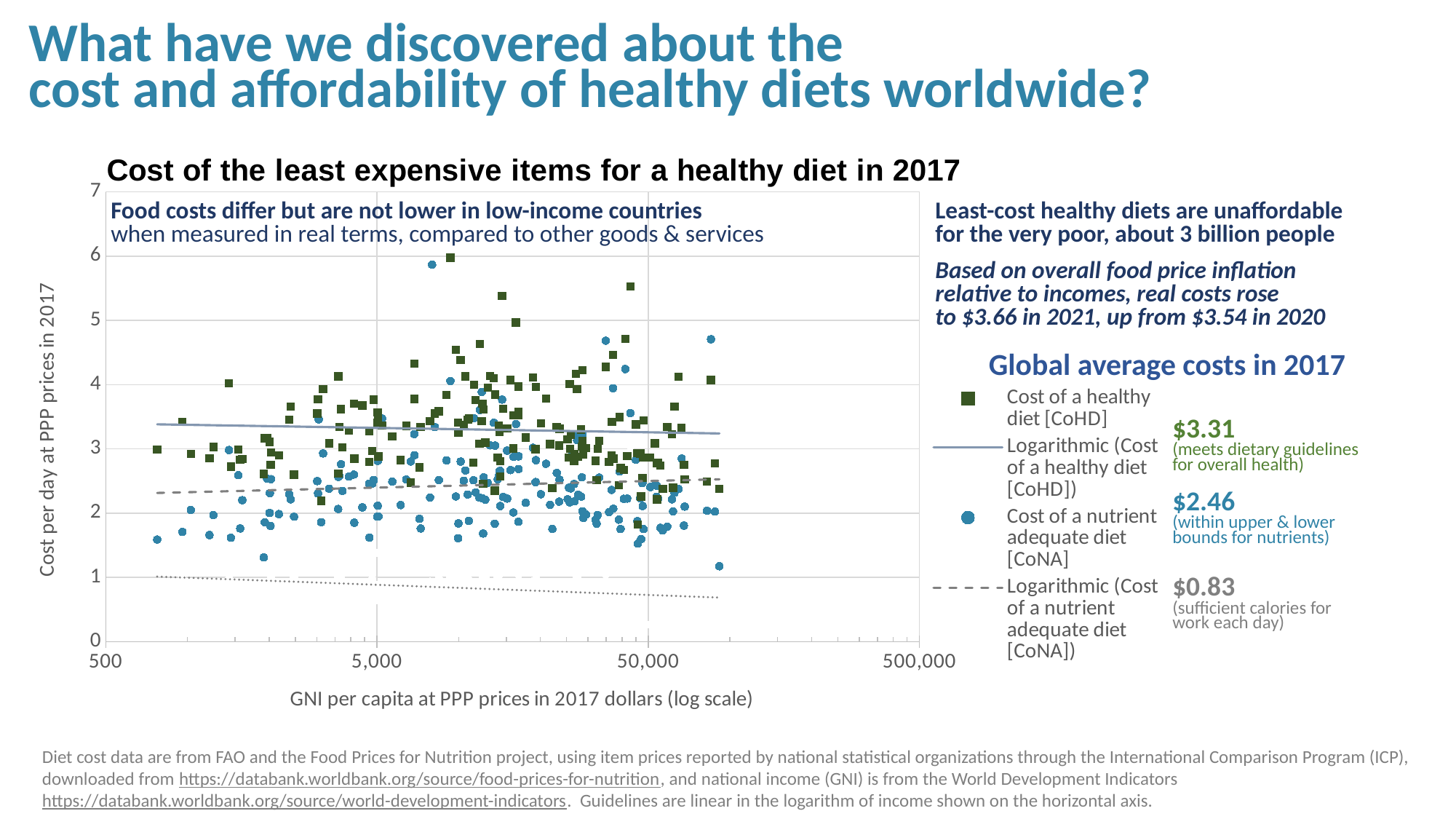
What is the global average cost in 2017 for sufficient calories for work each day? $0.83 Which series contains the lowest plotted point on the chart? Cost of a nutrient adequate diet [CoNA] What is the global average cost of a nutrient adequate diet [CoNA] in 2017 shown on the slide? $2.46 What kind of chart is shown on the slide? Scatter chart How many tick labels are shown on the horizontal (GNI per capita) axis? 4 What is the global average cost of a healthy diet [CoHD] in 2017 shown on the slide? $3.31 What marker shape and colour represent the cost of a healthy diet [CoHD] on the chart? Green squares How many entries does the chart legend list? 4 Which has the higher global average cost in 2017: the healthy diet [CoHD] or the nutrient adequate diet [CoNA]? Cost of a healthy diet [CoHD] Does the logarithmic trend line for the cost of a healthy diet [CoHD] rise or fall as GNI per capita increases? Fall What is the difference between the global average cost of a healthy diet ($3.31) and the cost of a nutrient adequate diet ($2.46)? $0.85 What is the title of the chart? Cost of the least expensive items for a healthy diet in 2017